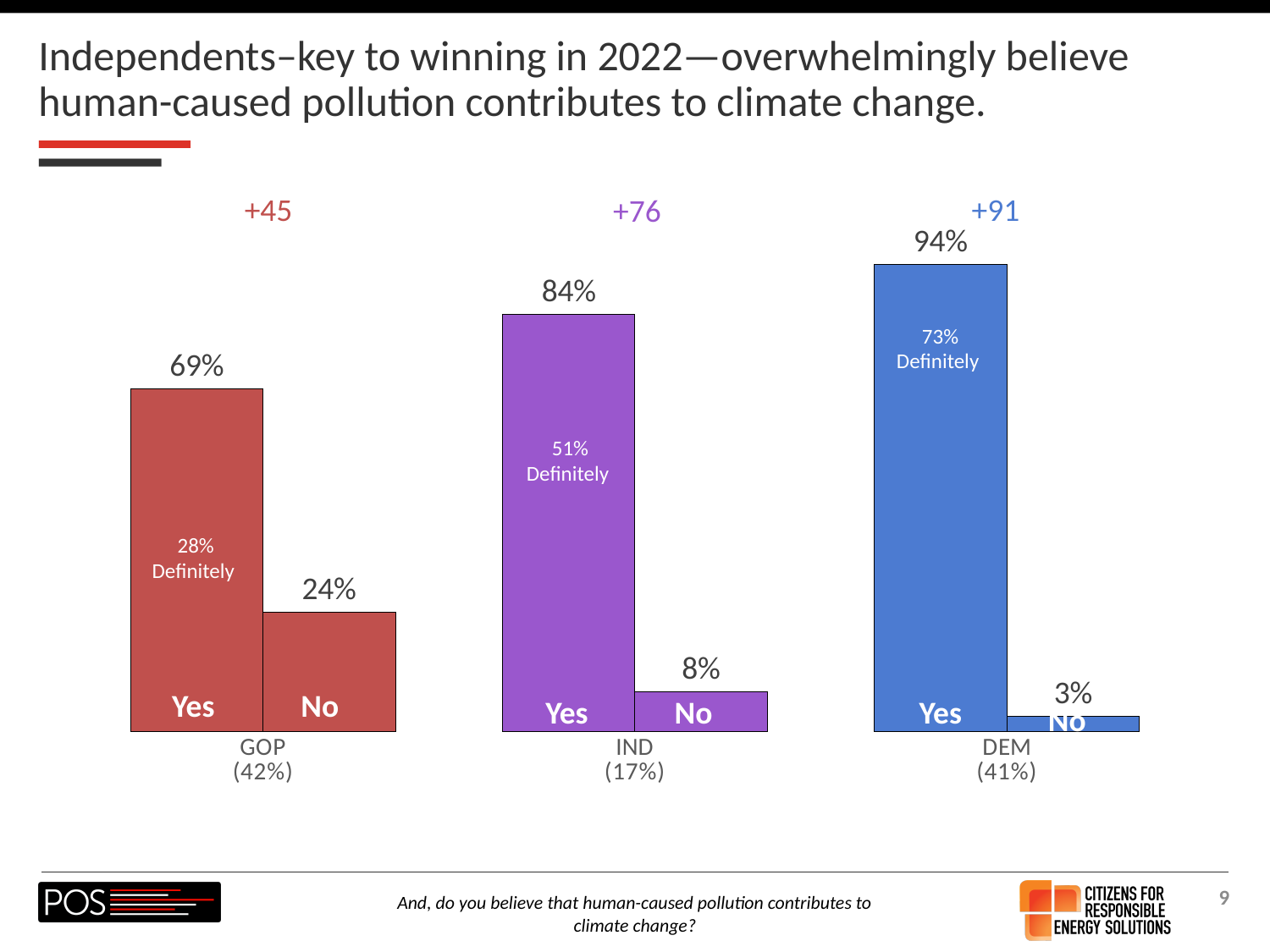
Which party group has the highest Yes percentage? DEM How many party groups are shown in the chart? 3 What net figure (Yes minus No) is shown above the IND bars? +76 What percentage of GOP respondents said 'Definitely'? 28% Which is larger, the GOP No percentage or the IND No percentage? GOP No percentage What percentage of Democrats (DEM) answered No? 3% What colour are the DEM bars? Blue Which party group has the lowest No percentage? DEM What kind of chart is shown on the slide? Bar chart What is the difference between the Yes and No percentages for GOP? 45 What percentage of Independents (IND) answered Yes? 84% What is the difference between the IND Yes percentage and the GOP Yes percentage? 15